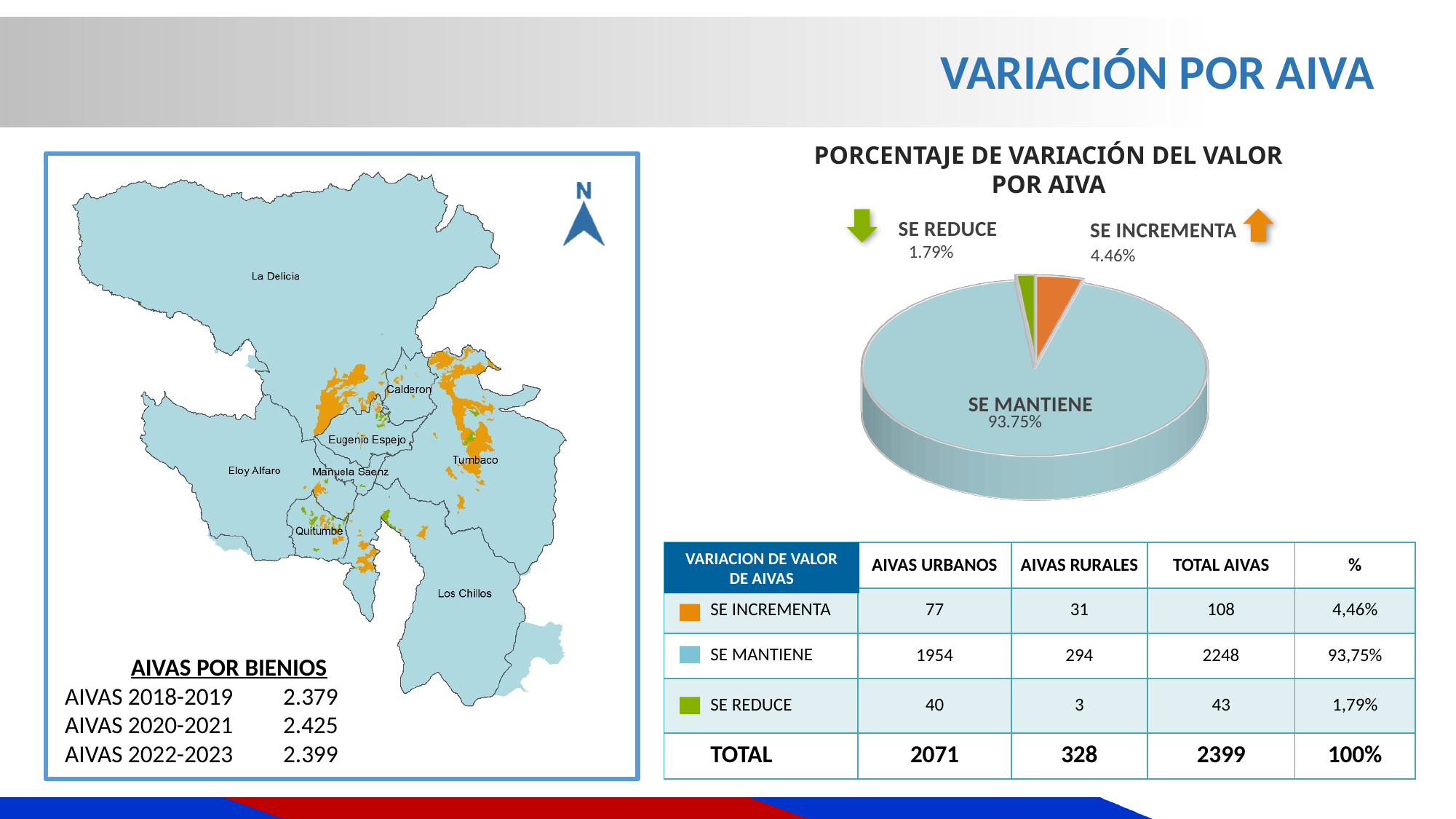
In the pie chart, what percentage is shown for SE REDUCE? 1.79% What kind of chart is shown under the title "PORCENTAJE DE VARIACIÓN DEL VALOR POR AIVA"? Pie chart In the pie chart, what colour is the SE REDUCE slice? Green How many slices does the pie chart have? 3 In the pie chart, what percentage is shown for SE INCREMENTA? 4.46% In the pie chart, what percentage is shown for SE MANTIENE? 93.75% In the pie chart, is the share for SE MANTIENE greater or less than 90%? greater In the pie chart, what is the difference in percentage points between SE INCREMENTA and SE REDUCE? 2.67 Which slice of the pie chart is the largest? SE MANTIENE In the pie chart, which is larger: SE INCREMENTA or SE REDUCE? SE INCREMENTA In the pie chart, what colour is the SE INCREMENTA slice? Orange Which slice of the pie chart is the smallest? SE REDUCE